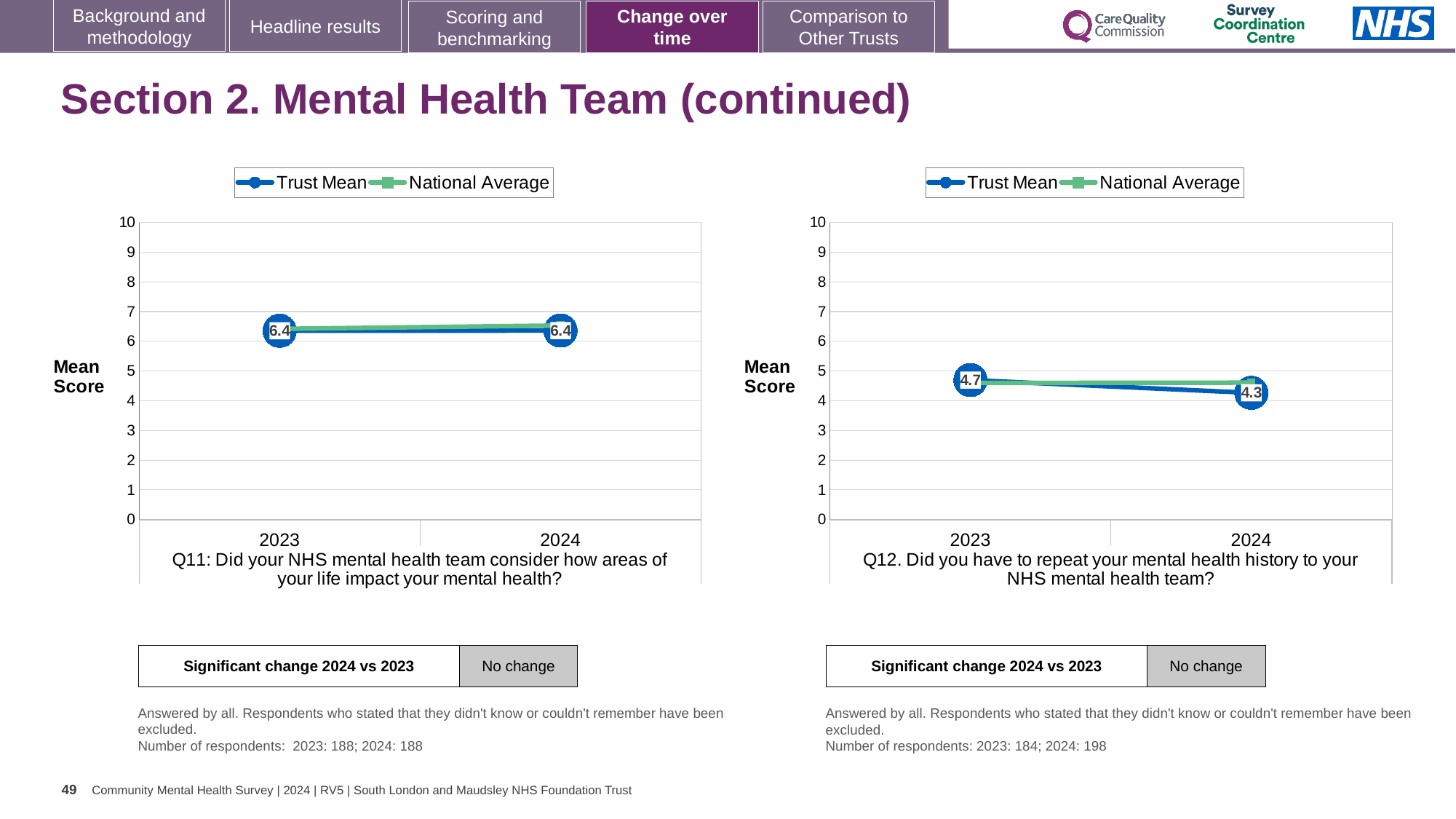
On the left chart (Q11), what is the Trust Mean score for 2023? 6.4 How many years are shown on the x axis of the left chart (Q11)? 2 On the right chart (Q12), does the Trust Mean rise or fall from 2023 to 2024? fall On the right chart (Q12), which year has the higher Trust Mean score, 2023 or 2024? 2023 On the right chart (Q12), what is the Trust Mean score for 2023? 4.7 On the right chart (Q12), what is the Trust Mean score for 2024? 4.3 On the left chart (Q11), is the National Average value for 2024 greater or less than 6? greater What kind of chart is the left chart (Q11)? line chart On the right chart (Q12), is the National Average value for 2024 greater or less than 4? greater On the right chart (Q12), what is the difference between the Trust Mean scores for 2023 and 2024? 0.4 On the left chart (Q11), what is the Trust Mean score for 2024? 6.4 How many series does the legend of the right chart (Q12) list? 2